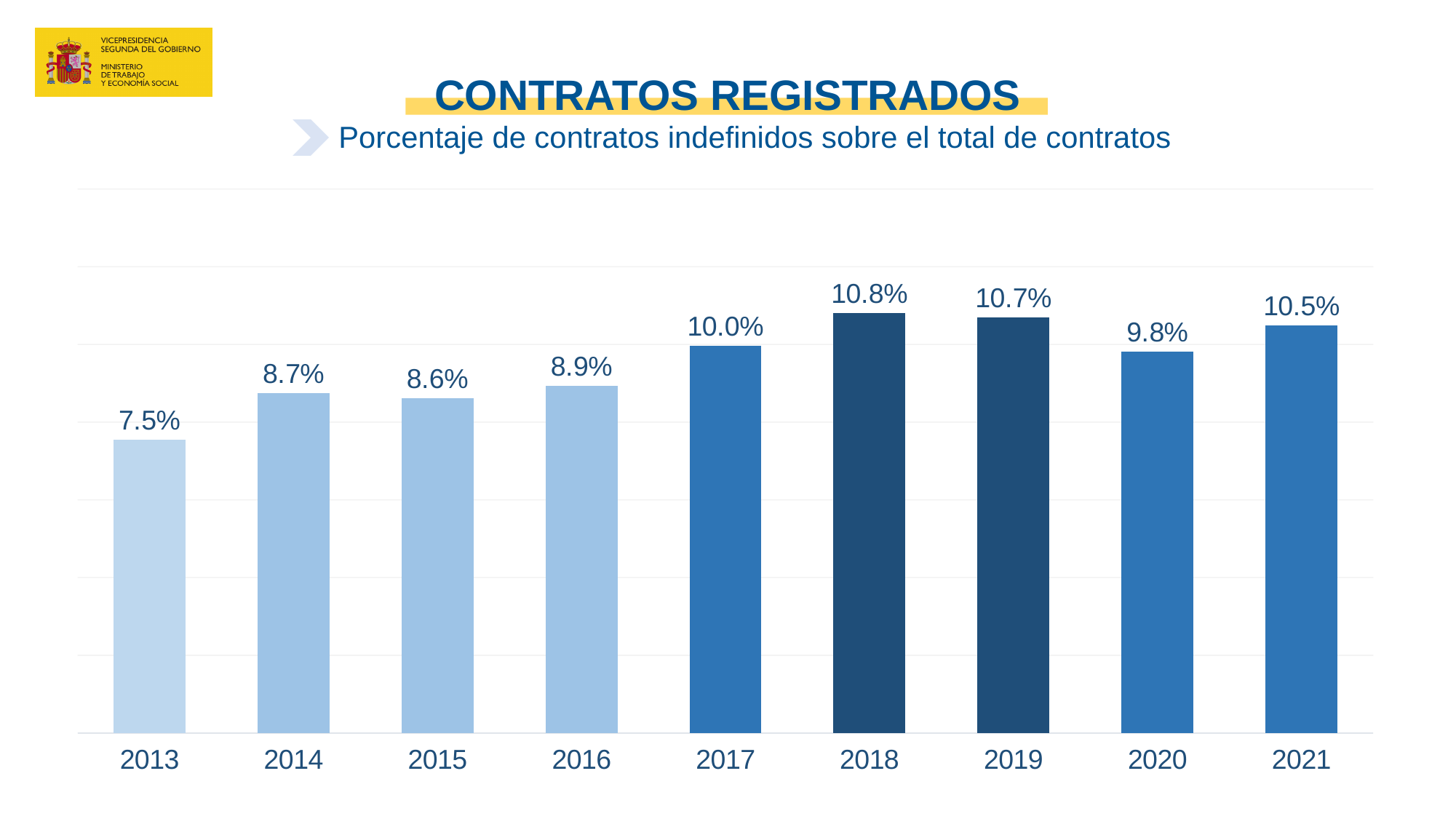
What is the difference between the values for 2018 and 2013? 3.3% Which year has the highest value? 2018 What is the value for 2018? 10.8% What is the value for 2013? 7.5% What kind of chart is shown on the slide? Bar chart How many years are shown on the x axis? 9 Which year has the lowest value? 2013 What is the value for 2016? 8.9% What is the value for 2020? 9.8% What is the difference between the values for 2021 and 2020? 0.7% What is the subtitle of the chart? Porcentaje de contratos indefinidos sobre el total de contratos Which is larger, the value for 2014 or the value for 2015? 2014